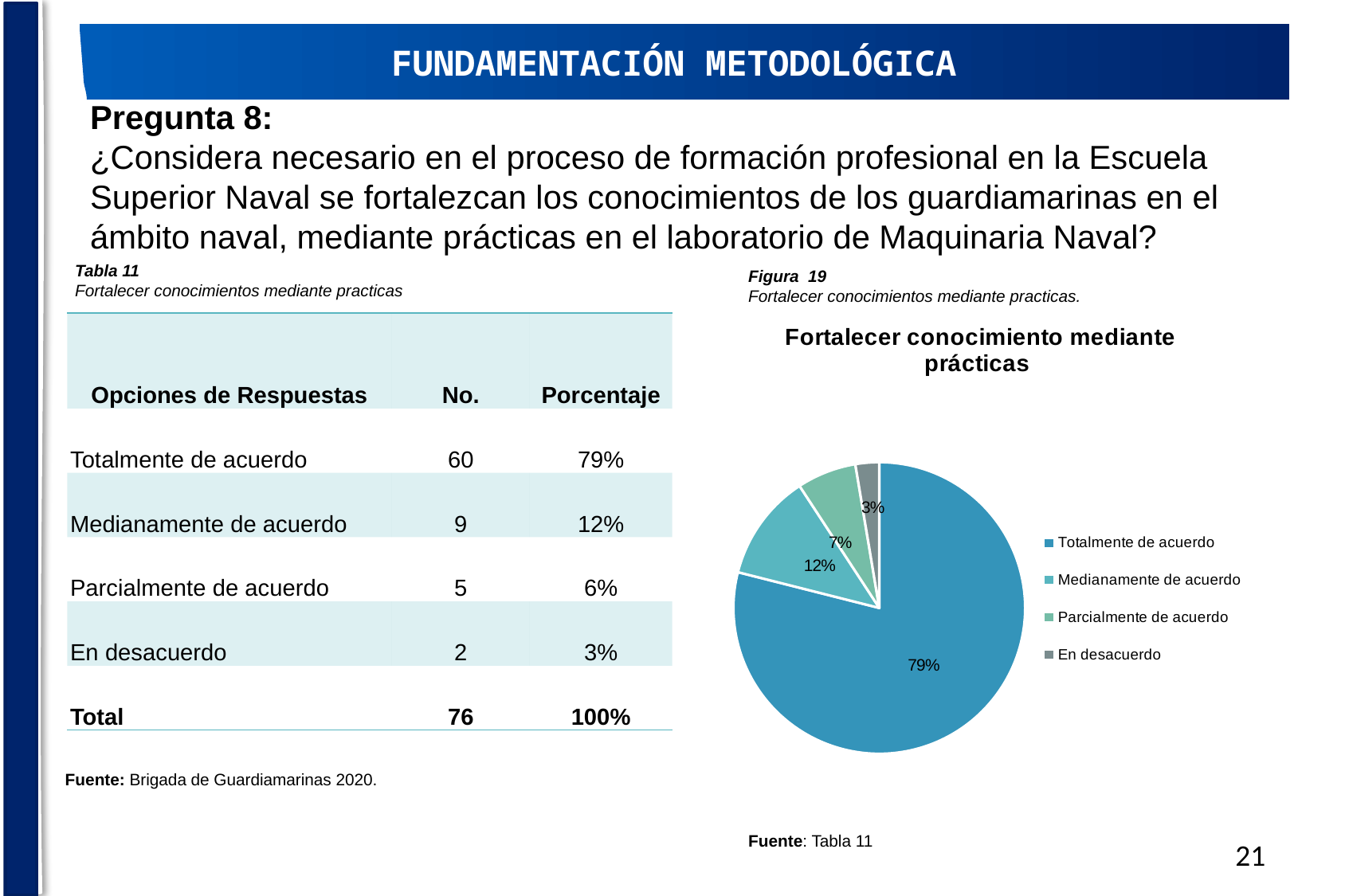
What percentage does the pie chart show for Totalmente de acuerdo? 79% In the pie chart, what is the difference in percentage points between Totalmente de acuerdo and Medianamente de acuerdo? 67 How many slices does the pie chart have? 4 What is the title of the pie chart? Fortalecer conocimiento mediante prácticas What percentage does the pie chart show for Parcialmente de acuerdo? 7% What percentage does the pie chart show for En desacuerdo? 3% Which category has the largest slice in the pie chart? Totalmente de acuerdo What percentage does the pie chart show for Medianamente de acuerdo? 12% In the pie chart, which is larger: Medianamente de acuerdo or Parcialmente de acuerdo? Medianamente de acuerdo What kind of chart is shown on the slide? Pie chart Which category has the smallest slice in the pie chart? En desacuerdo How many entries does the legend of the pie chart list? 4